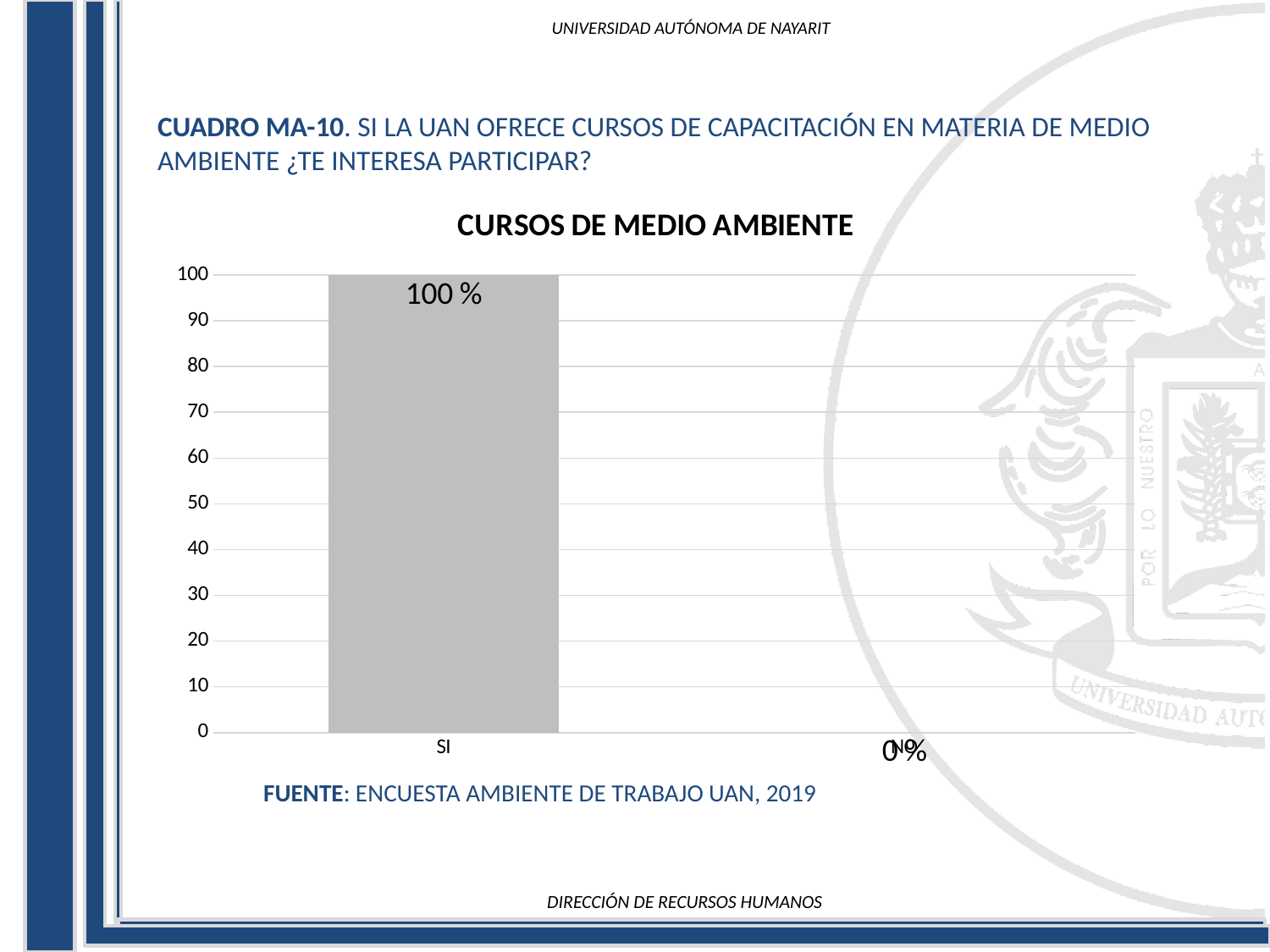
How many categories are shown on the x axis? 2 Is the value for SI greater or less than 50? greater What is the value for SI? 100 % Which is larger, the value for SI or the value for NO? SI What is the maximum value shown on the y axis? 100 What is the title of the chart? CURSOS DE MEDIO AMBIENTE Which category has the highest value? SI What is the value for NO? 0% What kind of chart is shown? bar chart Which category has the lowest value? NO What is the difference between the values for SI and NO? 100